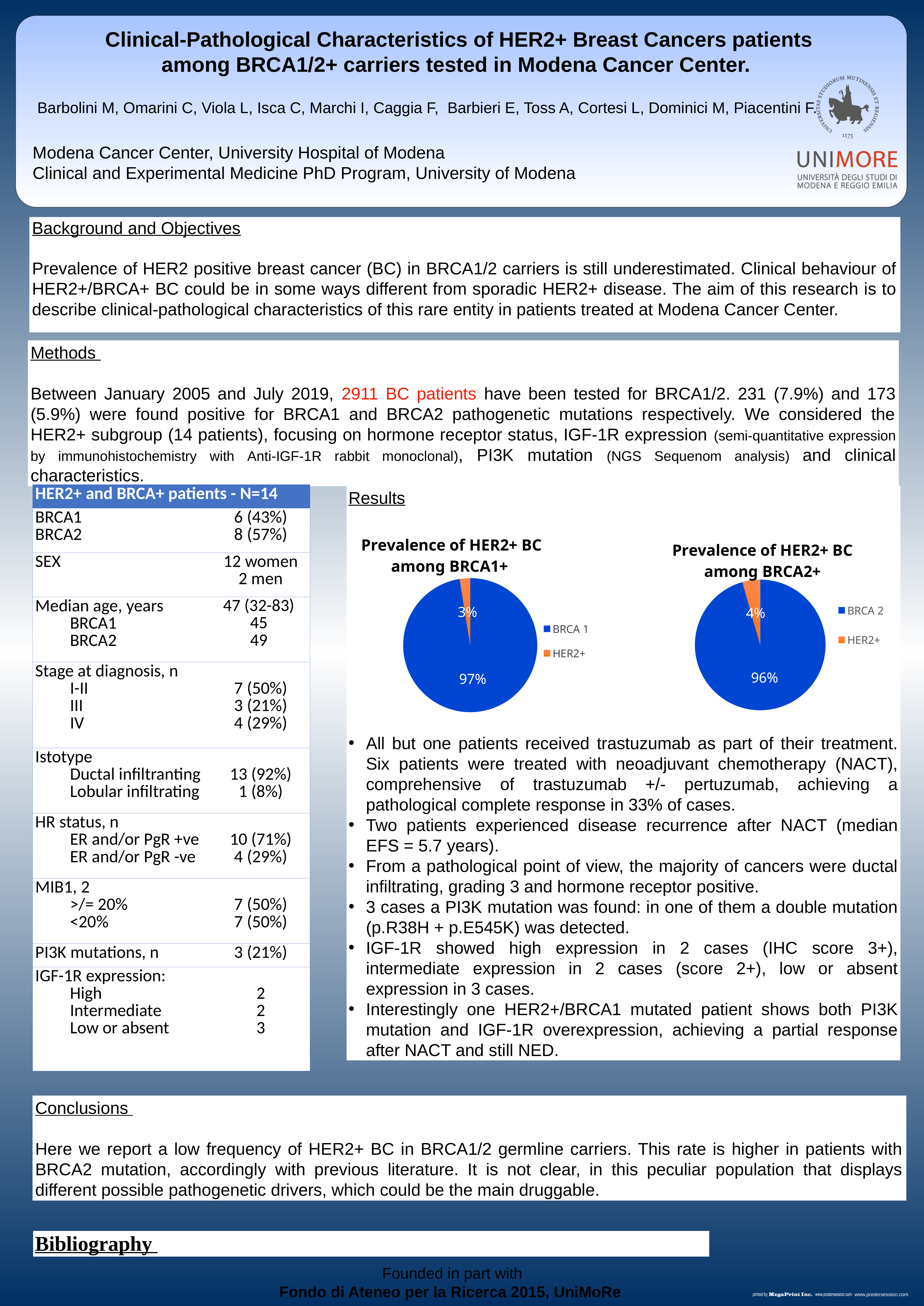
Which is larger: the HER2+ share in the "Prevalence of HER2+ BC among BRCA1+" chart or the HER2+ share in the "Prevalence of HER2+ BC among BRCA2+" chart? Prevalence of HER2+ BC among BRCA2+ In the chart titled "Prevalence of HER2+ BC among BRCA1+", which slice is the largest? BRCA 1 In the chart titled "Prevalence of HER2+ BC among BRCA2+", what colour is the HER2+ slice? Orange In the chart titled "Prevalence of HER2+ BC among BRCA2+", what share of the pie is labelled BRCA 2? 96% What kind of chart is "Prevalence of HER2+ BC among BRCA1+"? Pie chart How many slices does the pie chart "Prevalence of HER2+ BC among BRCA2+" have? 2 In the chart titled "Prevalence of HER2+ BC among BRCA1+", what share of the pie is labelled HER2+? 3% In the chart titled "Prevalence of HER2+ BC among BRCA2+", what share of the pie is labelled HER2+? 4% In the chart titled "Prevalence of HER2+ BC among BRCA2+", which slice is the smallest? HER2+ How many entries does the legend of the chart "Prevalence of HER2+ BC among BRCA1+" list? 2 What is the difference between the BRCA 1 share (97%) and the HER2+ share (3%) in the chart "Prevalence of HER2+ BC among BRCA1+"? 94%